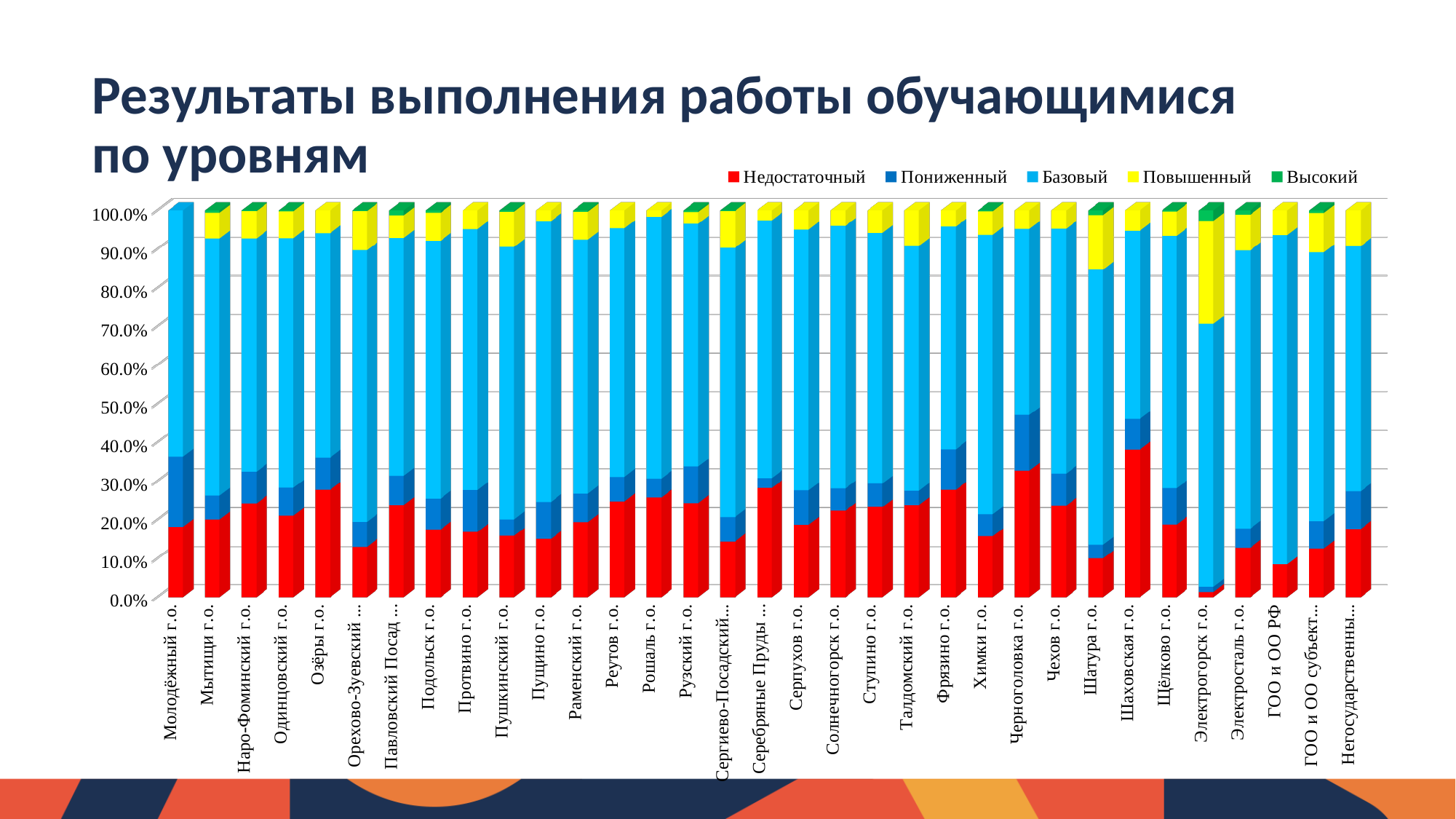
Is the Повышенный value for Электрогорск г.о. greater or less than 20%? greater Is the Недостаточный value for Электрогорск г.о. greater or less than 10%? less What kind of chart is shown on the slide? stacked bar chart How many series does the legend list? 5 Is the Недостаточный value for Шаховская г.о. greater or less than 30%? greater Which category has the lowest share of Недостаточный? Электрогорск г.о. Which has a larger Недостаточный share: Шатура г.о. or Черноголовка г.о.? Черноголовка г.о. How many categories are shown along the x axis? 33 Which category has the largest Повышенный segment? Электрогорск г.о. Which category has the highest share of Недостаточный? Шаховская г.о. Which series is shown in red in the legend? Недостаточный What is the title of the slide? Результаты выполнения работы обучающимися по уровням